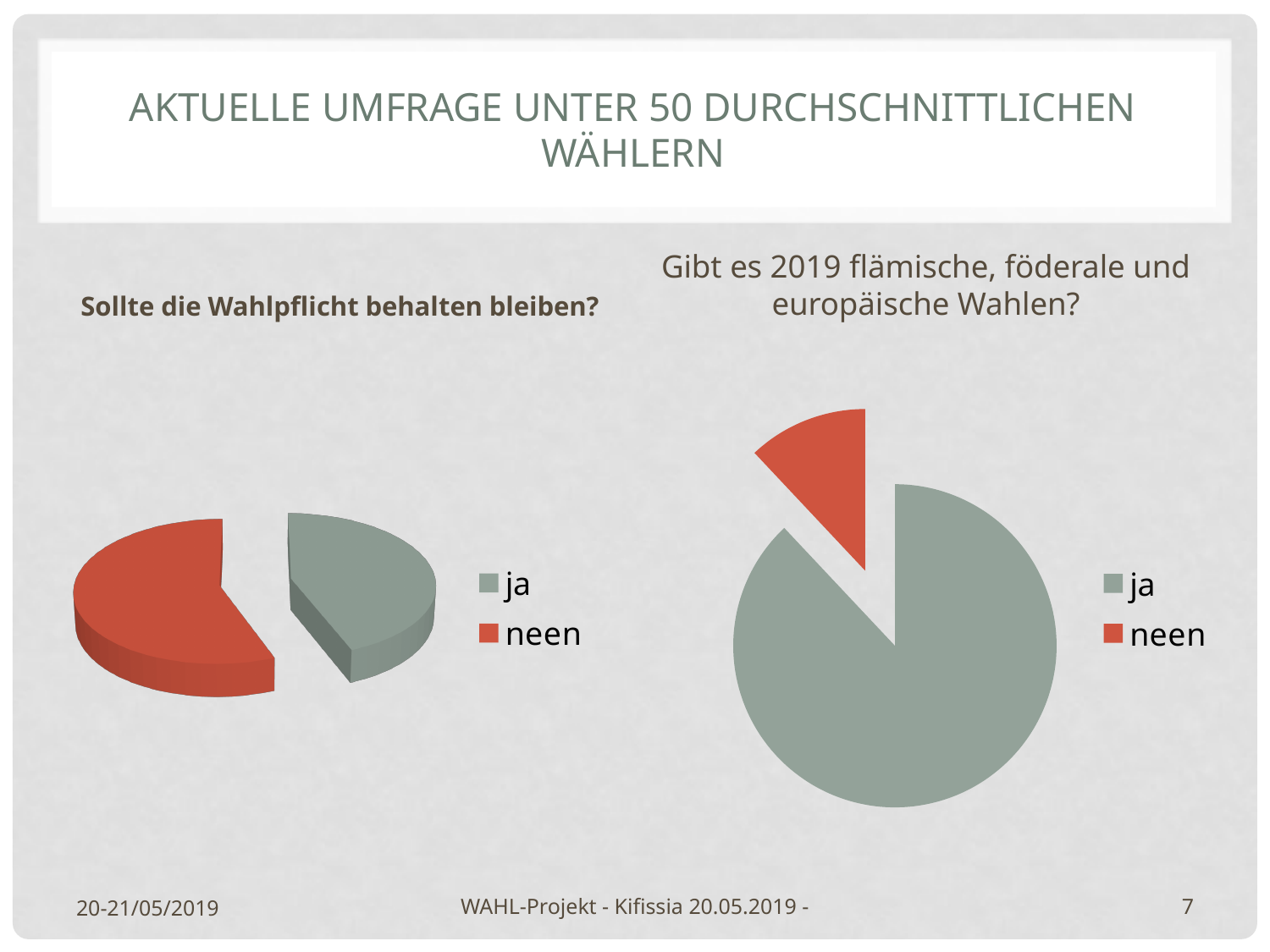
How many pie charts are shown on the slide? 2 In the chart "Gibt es 2019 flämische, föderale und europäische Wahlen?", is the slice for ja or the slice for neen larger? ja How many entries does the legend of the chart "Gibt es 2019 flämische, föderale und europäische Wahlen?" list? 2 In the chart "Sollte die Wahlpflicht behalten bleiben?", what colour is the slice for neen? red In the chart "Sollte die Wahlpflicht behalten bleiben?", which category has the smallest slice? ja How many slices does the chart "Sollte die Wahlpflicht behalten bleiben?" have? 2 In the chart "Sollte die Wahlpflicht behalten bleiben?", which category has the largest slice? neen What kind of chart is shown under the title "Gibt es 2019 flämische, föderale und europäische Wahlen?"? pie chart In the chart "Sollte die Wahlpflicht behalten bleiben?", is the slice for ja or the slice for neen larger? neen In the chart "Gibt es 2019 flämische, föderale und europäische Wahlen?", which category has the smallest slice? neen What kind of chart is shown under the title "Sollte die Wahlpflicht behalten bleiben?"? pie chart In the chart "Gibt es 2019 flämische, föderale und europäische Wahlen?", which category has the largest slice? ja